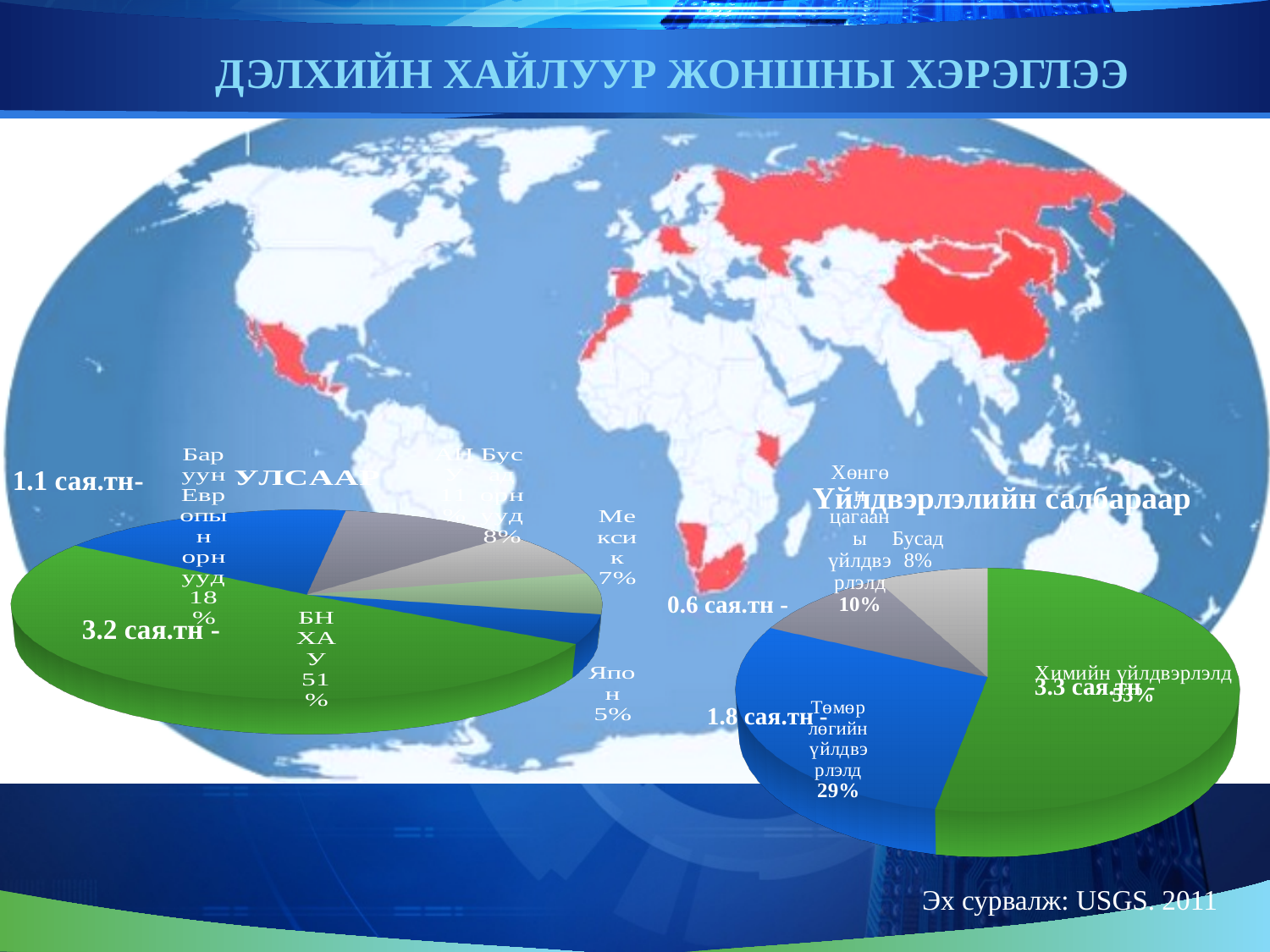
In the 'Үйлдвэрлэлийн салбараар' pie chart, which category has the smallest share? Бусад In the 'УЛСААР' pie chart, which category has the largest share? БНХАУ How many slices does the 'Үйлдвэрлэлийн салбараар' pie chart have? 4 In the 'УЛСААР' pie chart, what share does Мексик have? 7% In the 'Үйлдвэрлэлийн салбараар' pie chart, what share does Төмөрлөгийн үйлдвэрлэлд have? 29% In the 'УЛСААР' pie chart, what share does Япон have? 5% In the 'УЛСААР' pie chart, what share does БНХАУ have? 51% In the 'УЛСААР' pie chart, what share do the Баруун Европын орнууд have? 18% In the 'УЛСААР' pie chart, which is larger, Мексик or Япон? Мексик In the 'Үйлдвэрлэлийн салбараар' pie chart, what is the difference between the shares of Химийн үйлдвэрлэлд and Төмөрлөгийн үйлдвэрлэлд? 24% In the 'Үйлдвэрлэлийн салбараар' pie chart, what share does Химийн үйлдвэрлэлд have? 53% In the 'Үйлдвэрлэлийн салбараар' pie chart, what share does Хөнгөн цагааны үйлдвэрлэлд have? 10%